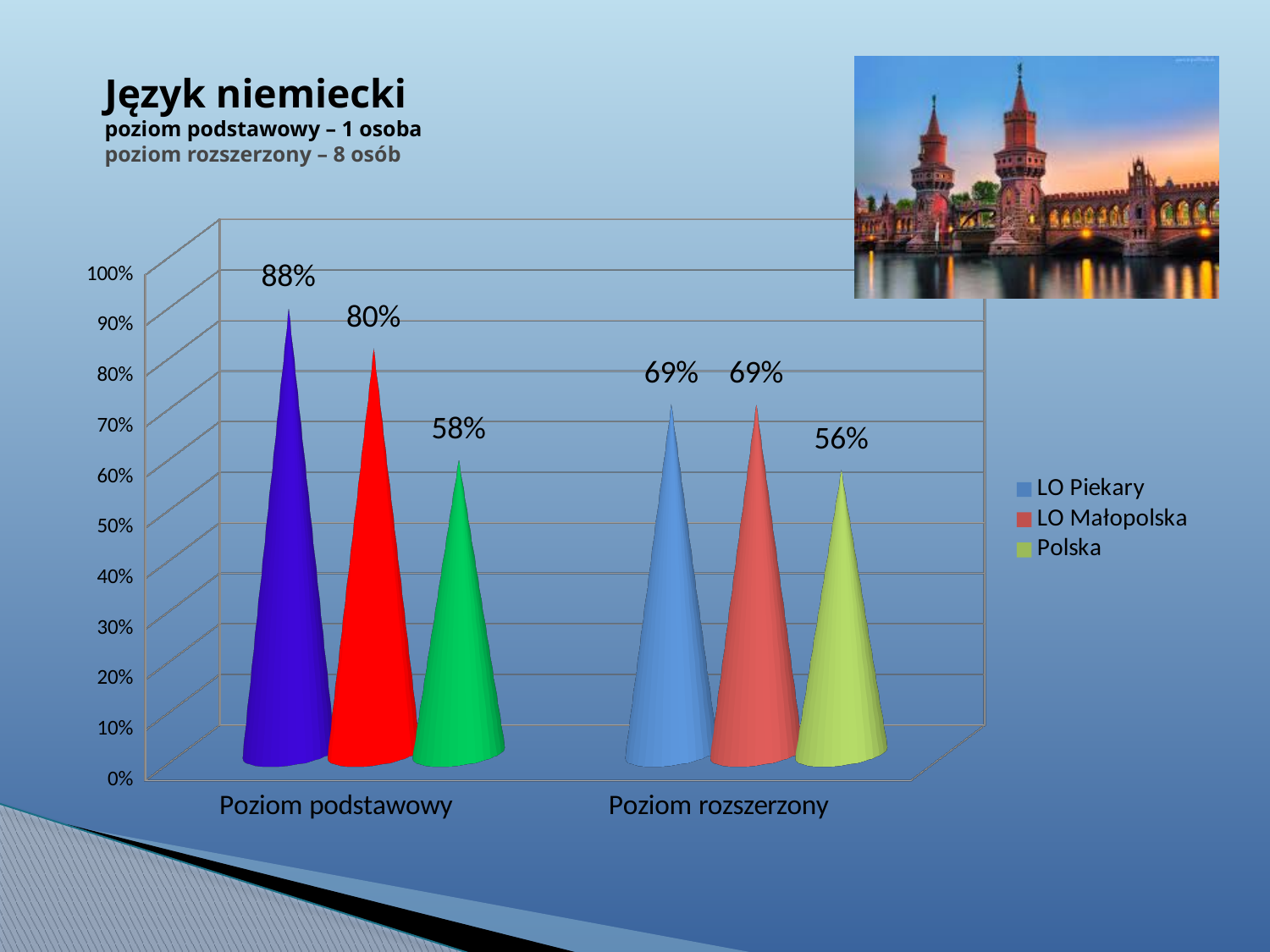
What is the difference between the LO Piekary and Polska values at Poziom podstawowy? 30% Which is larger: the LO Małopolska value at Poziom podstawowy or at Poziom rozszerzony? Poziom podstawowy What is the value for Polska at Poziom rozszerzony? 56% How many series does the legend list? 3 How many categories are shown on the x axis? 2 What is the value for Polska at Poziom podstawowy? 58% Which series has the highest value at Poziom podstawowy? LO Piekary Which series has the lowest value at Poziom rozszerzony? Polska What is the value for LO Piekary at Poziom podstawowy? 88% What is the value for LO Piekary at Poziom rozszerzony? 69% What kind of chart is shown on the slide? Bar chart What is the value for LO Małopolska at Poziom podstawowy? 80%